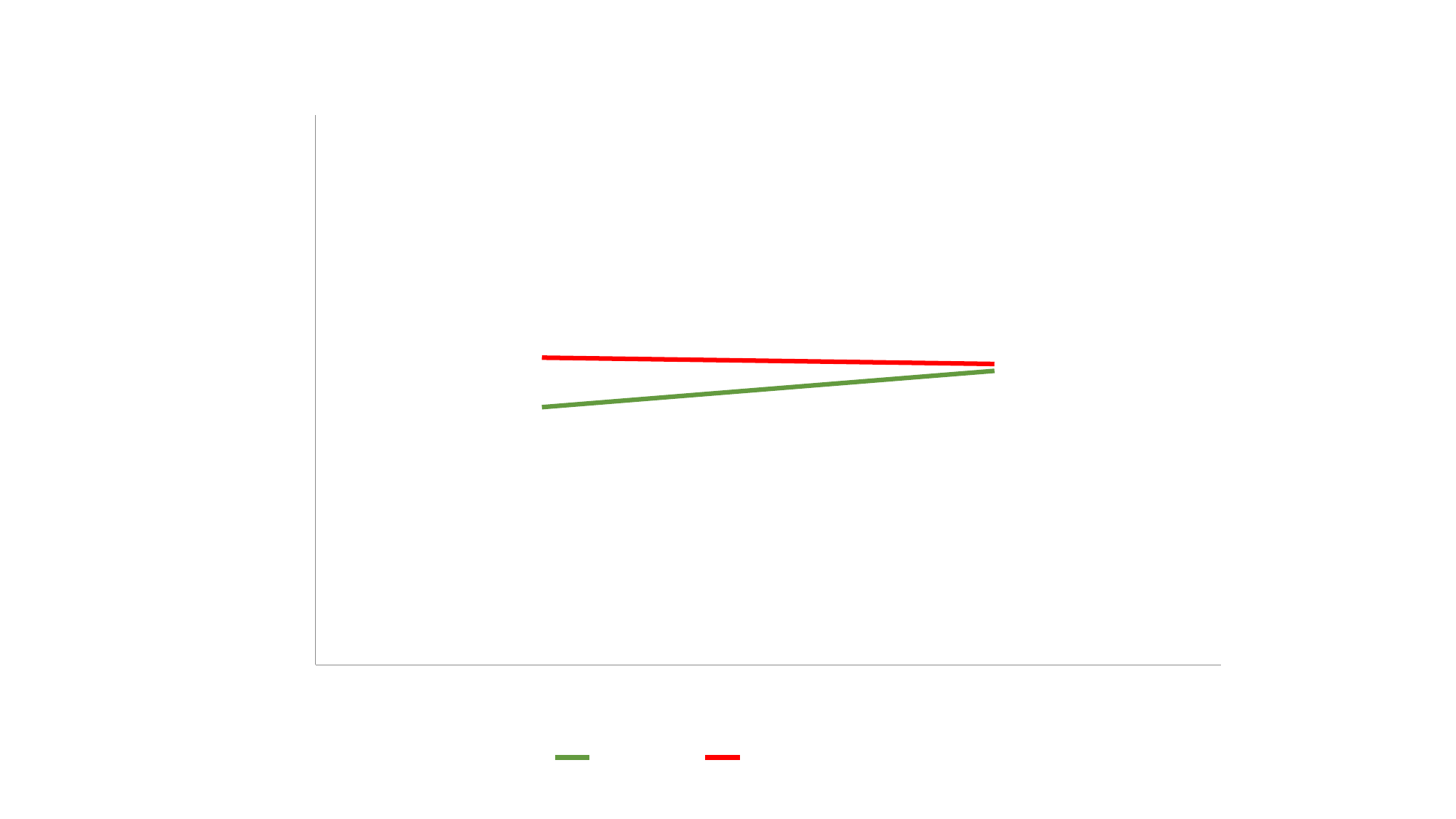
What kind of chart is shown on the slide? line chart Where is the legend positioned relative to the plot area? below it Does the red line rise or fall from left to right? falls What colours are the two lines plotted on the chart? green and red How many data points does the green line have? 2 Does the green line rise or fall from left to right? rises At the left end of the chart, which line is higher, the green or the red? red How many series does the legend list? 2